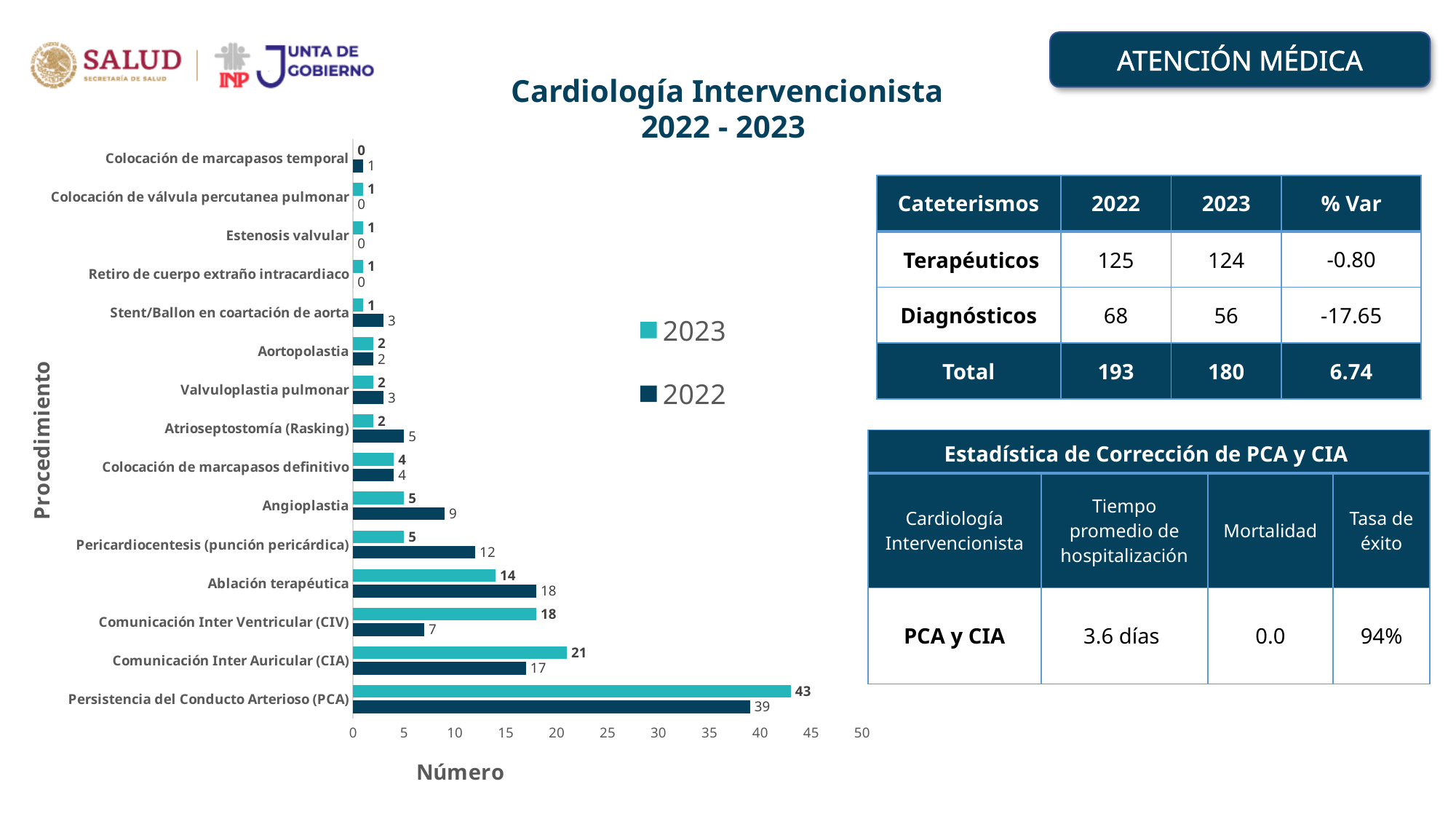
For Ablación terapéutica, which year has the larger value, 2022 or 2023? 2022 What is the 2023 value for Comunicación Inter Ventricular (CIV)? 18 Which procedure has the lowest 2023 value? Colocación de marcapasos temporal Is the 2022 value for Persistencia del Conducto Arterioso (PCA) greater or less than 35? greater What is the 2022 value for Pericardiocentesis (punción pericárdica)? 12 What is the difference between the 2023 and 2022 values for Comunicación Inter Auricular (CIA)? 4 How many procedures (categories) are shown on the chart? 15 What kind of chart is shown on the slide? bar chart How many series does the chart legend list? 2 What is the 2023 value for Persistencia del Conducto Arterioso (PCA)? 43 What is the label of the x axis of the chart? Número Which procedure has the highest 2022 value? Persistencia del Conducto Arterioso (PCA)